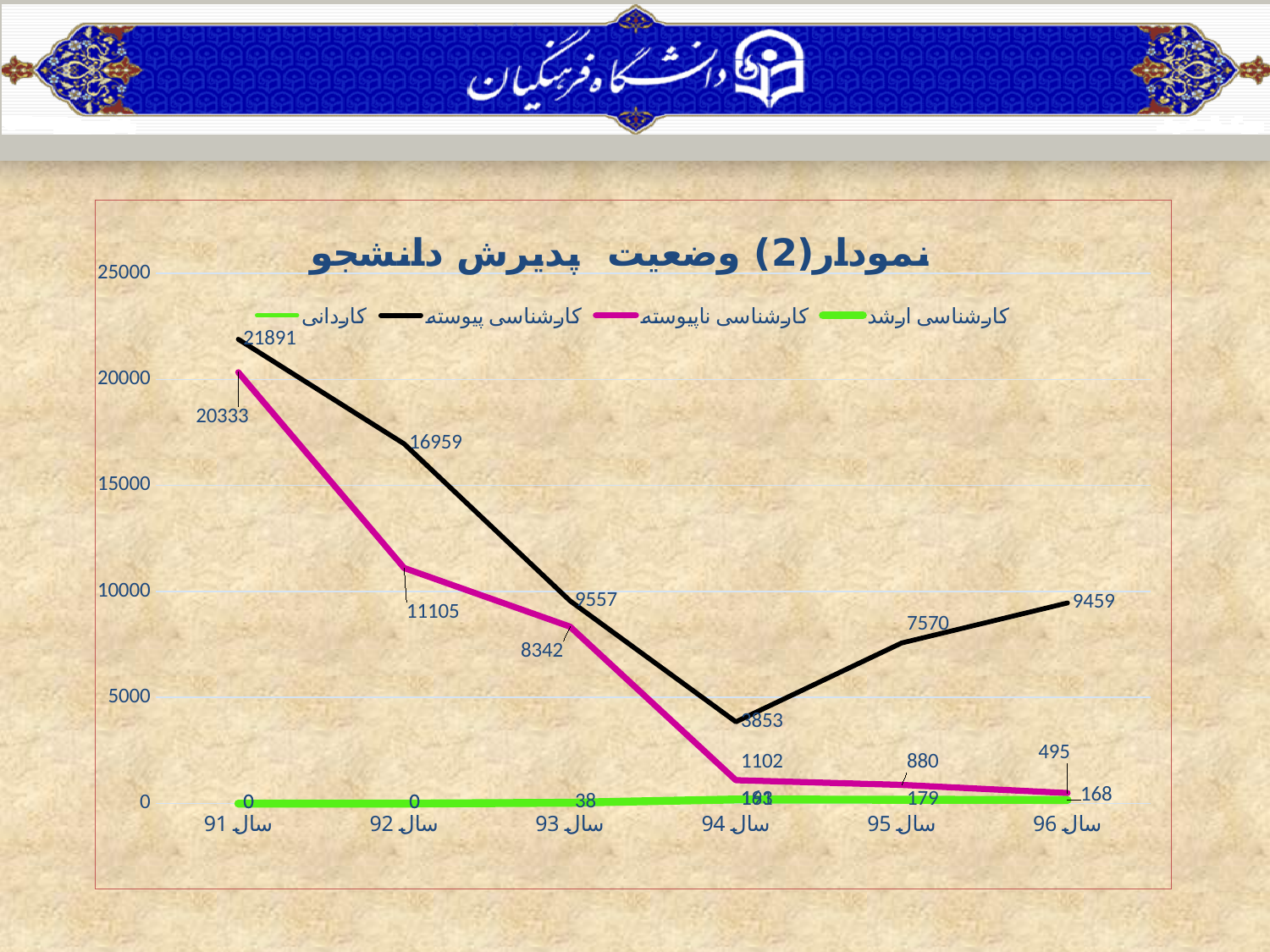
What is the title of the chart? نمودار(2) وضعیت پدیرش دانشجو In which year is کارشناسی پیوسته at its lowest? سال 94 How many series does the legend list? 4 Does the کارشناسی ناپیوسته series rise or fall from سال 91 to سال 96? fall In which year is کارشناسی پیوسته at its highest? سال 91 What is the difference between the کارشناسی پیوسته values in سال 96 and سال 95? 1889 How many years are shown on the x axis? 6 In سال 93, which is larger: کارشناسی پیوسته or کارشناسی ناپیوسته? کارشناسی پیوسته What is the value of کارشناسی ناپیوسته in سال 96? 495 What kind of chart is shown on the slide? line chart What is the value of کارشناسی ناپیوسته in سال 92? 11105 What is the value of کارشناسی پیوسته in سال 91? 21891